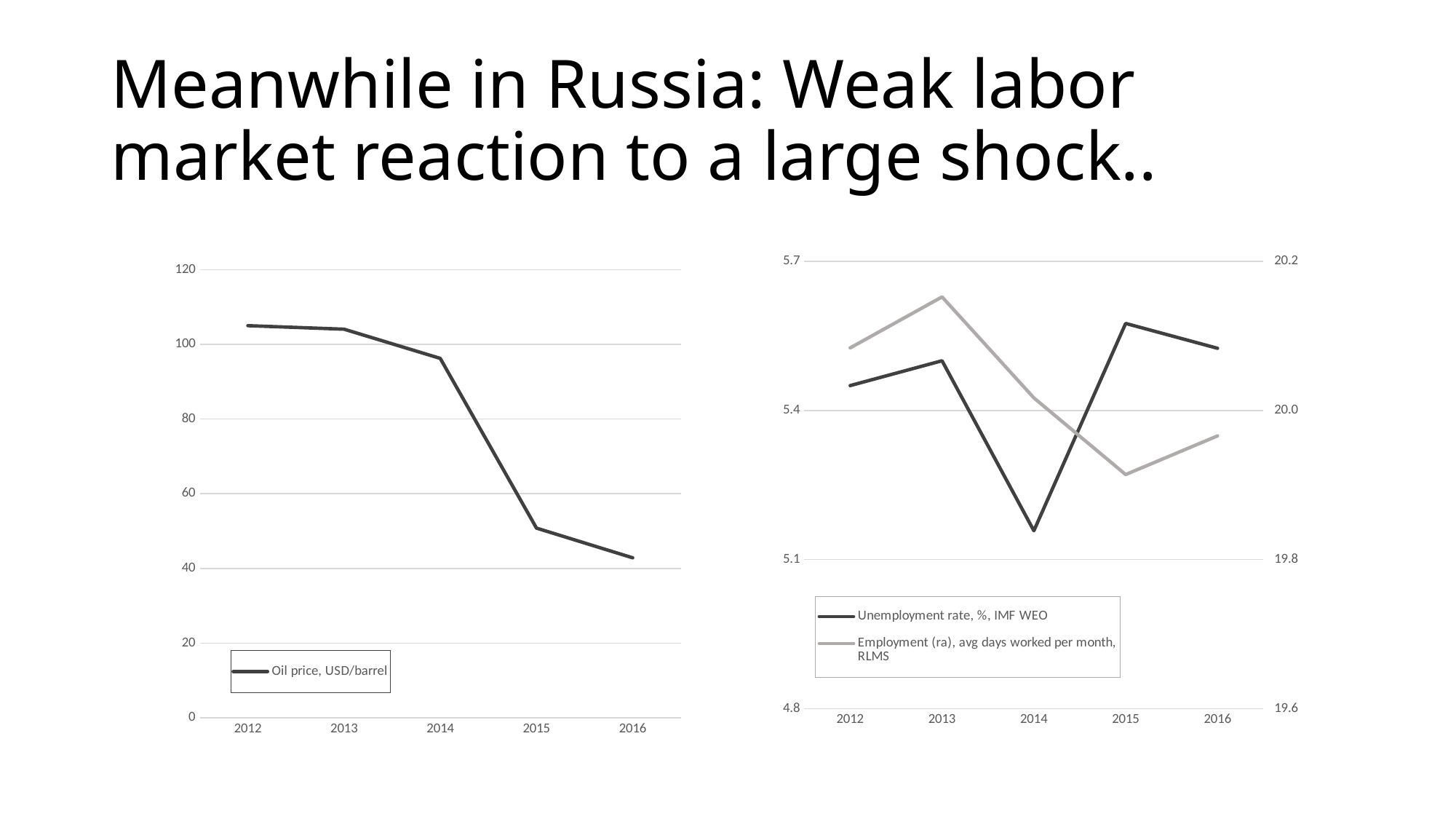
In the left chart, how many years are plotted on the x axis? 5 In the left chart, is the oil price for 2012 greater or less than 100? greater In the left chart, is the oil price for 2015 greater or less than 60? less In the left chart, does the oil price rise or fall from 2012 to 2016? fall In the right chart, how many series does the legend list? 2 In the right chart, is the unemployment rate larger in 2015 or in 2012? 2015 In the right chart, is the unemployment rate for 2014 greater or less than 5.4? less What is the legend entry of the left chart? Oil price, USD/barrel In the right chart, which year has the highest employment (avg days worked per month)? 2013 In the right chart, which year has the lowest unemployment rate? 2014 What kind of chart is the left chart showing oil price? line chart In the left chart, which year has the lowest oil price? 2016